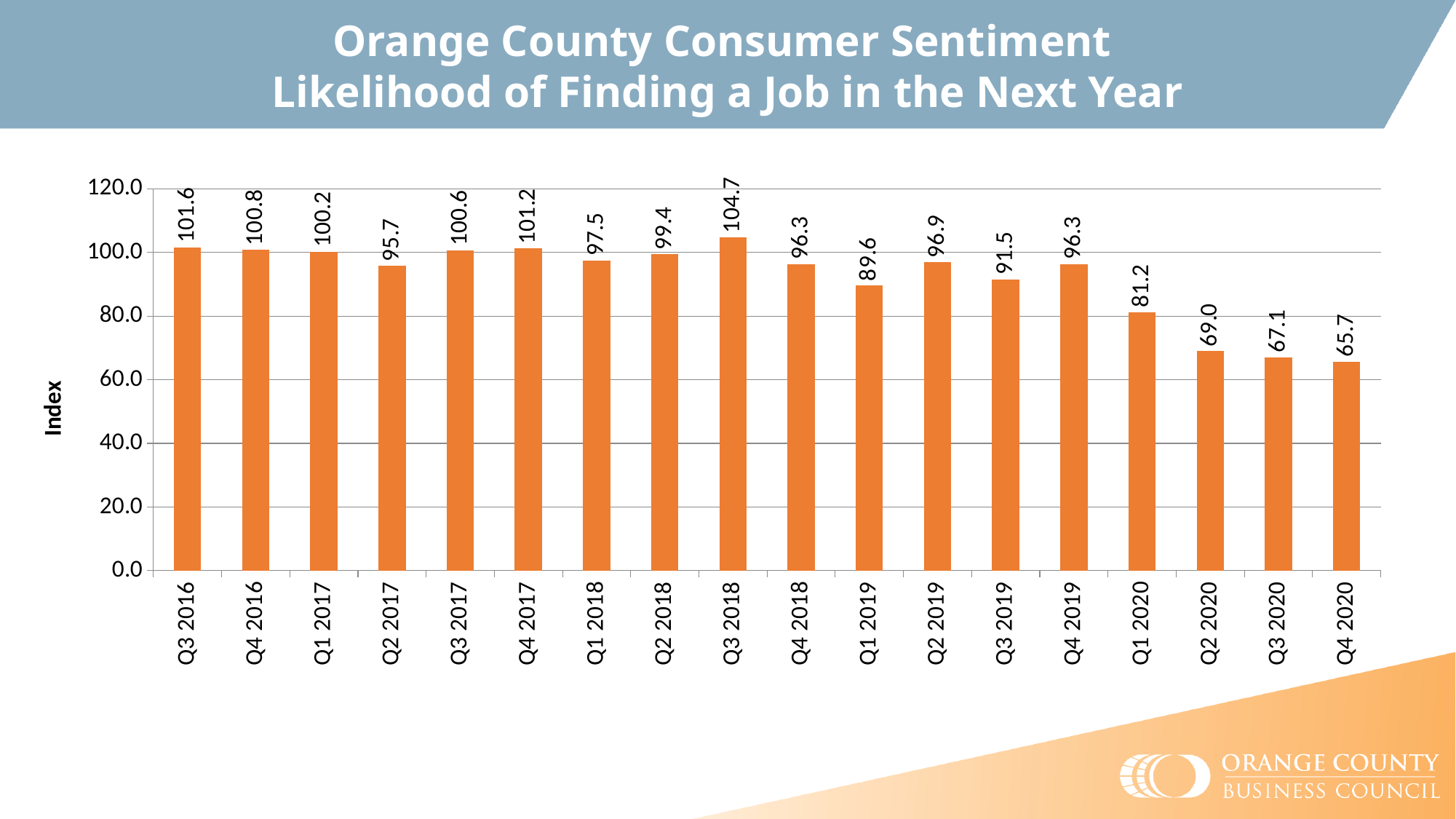
What is the difference between the index values for Q1 2020 and Q2 2020? 12.2 What is the index value for Q1 2020? 81.2 Do the index values generally rise or fall from Q4 2019 to Q4 2020? fall How many quarters are shown on the x axis? 18 What is the index value for Q3 2018? 104.7 Which quarter has the lowest index value? Q4 2020 Is the value for Q1 2019 greater or less than 100.0? less What is the label on the y axis? Index What is the index value for Q4 2020? 65.7 Which quarter has the highest index value? Q3 2018 What kind of chart is shown on the slide? bar chart Which is larger, the index value for Q2 2017 or Q3 2017? Q3 2017